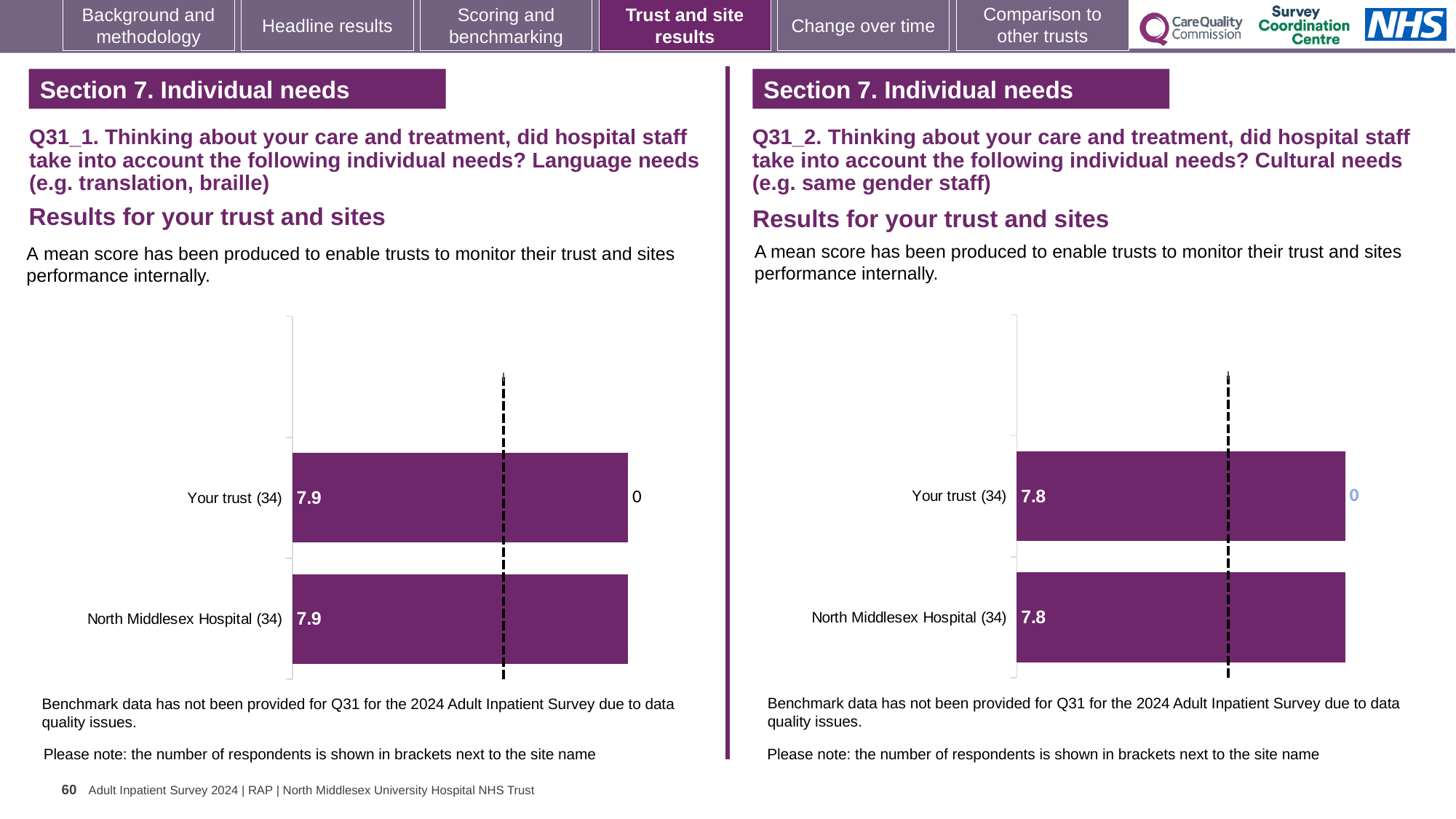
On the right chart (Q31_2, Cultural needs), what is the difference between the scores for Your trust and North Middlesex Hospital? 0 On the right chart (Q31_2, Cultural needs), what is the mean score for Your trust? 7.8 What is the difference between the Your trust score on the left chart (Q31_1) and the Your trust score on the right chart (Q31_2)? 0.1 On the left chart (Q31_1, Language needs), what is the mean score for Your trust? 7.9 On the left chart (Q31_1, Language needs), what is the mean score for North Middlesex Hospital? 7.9 How many bars are plotted on the right chart (Q31_2, Cultural needs)? 2 On the left chart (Q31_1, Language needs), what is the difference between the scores for Your trust and North Middlesex Hospital? 0 On the right chart (Q31_2, Cultural needs), what is the mean score for North Middlesex Hospital? 7.8 Which chart shows the higher score for Your trust: the left chart (Q31_1, Language needs) or the right chart (Q31_2, Cultural needs)? The left chart (Q31_1, Language needs) On the right chart (Q31_2, Cultural needs), how many respondents are shown in brackets next to North Middlesex Hospital? 34 How many bars are plotted on the left chart (Q31_1, Language needs)? 2 What type of chart is used on the left (Q31_1, Language needs)? Bar chart